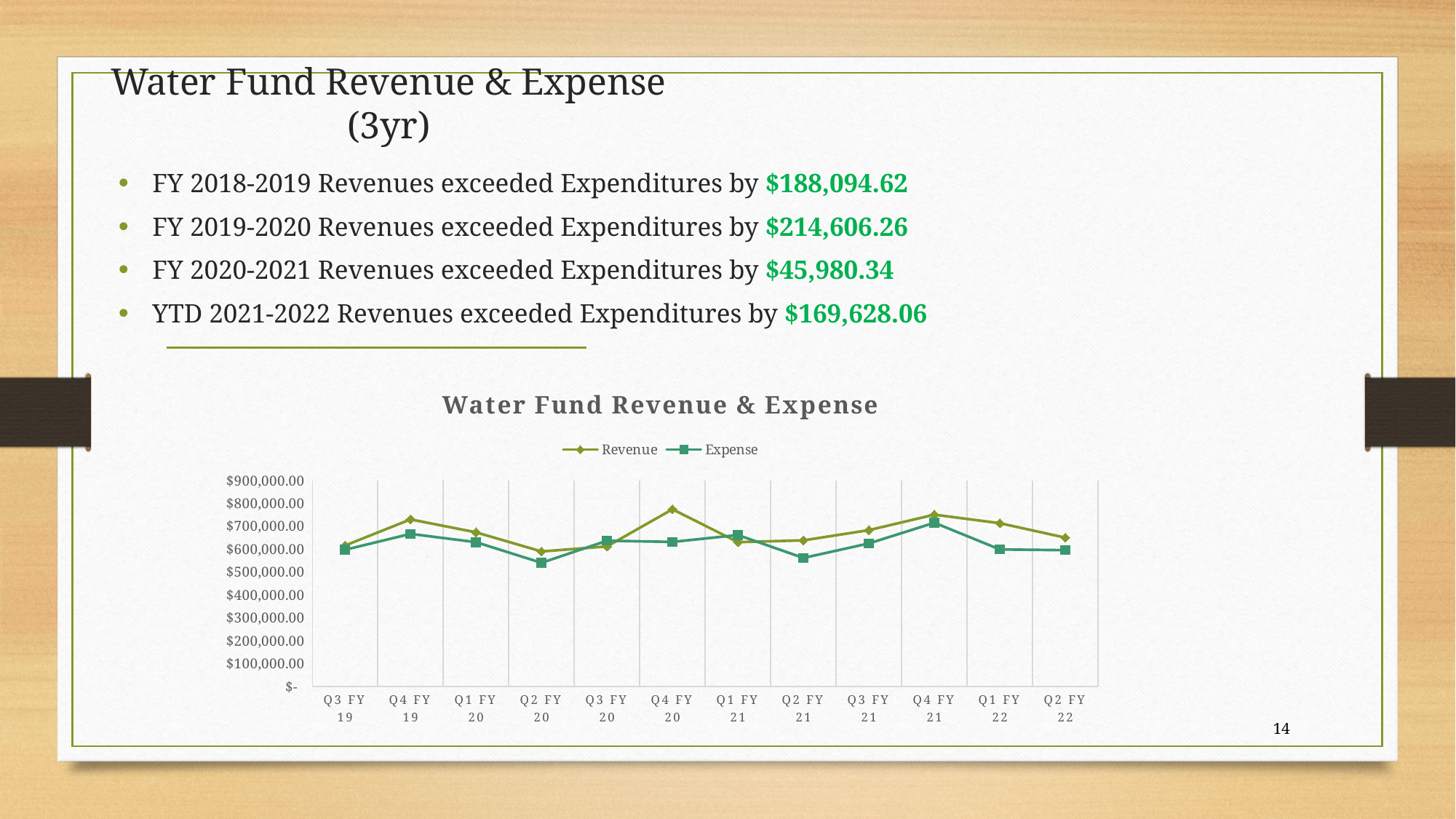
In which quarter does the Revenue series reach its lowest value? Q2 FY 20 Is the Revenue value for Q4 FY 20 greater or less than $700,000.00? greater In which quarter does the Expense series reach its highest value? Q4 FY 21 Is the Expense value for Q2 FY 21 greater or less than $600,000.00? less How many series does the chart legend list? 2 What are the two series named in the chart legend? Revenue and Expense What type of chart is shown on the slide? Line chart Is the Expense value for Q2 FY 20 greater or less than $600,000.00? less How many quarters are plotted along the x axis of the chart? 12 In Q4 FY 20, which is larger, Revenue or Expense? Revenue In which quarter does the Revenue series reach its highest value? Q4 FY 20 What is the title of the chart? Water Fund Revenue & Expense